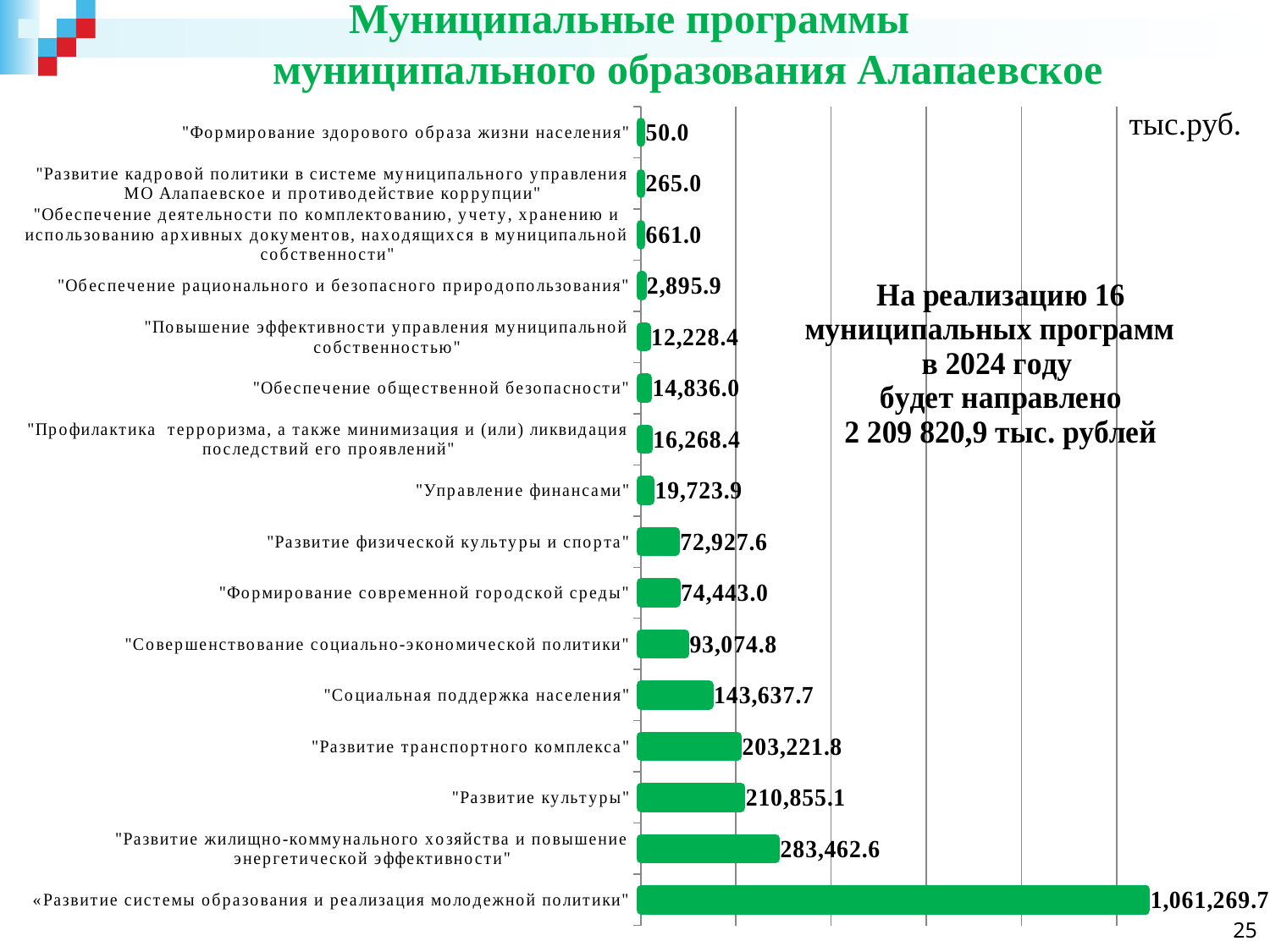
What is the value for "Социальная поддержка населения"? 143,637.7 How many programs (categories) are shown in the chart? 16 What is the value for "Управление финансами"? 19,723.9 What is the difference between the values for "Развитие культуры" and "Развитие транспортного комплекса"? 7,633.3 Which program has the highest value? «Развитие системы образования и реализация молодежной политики" What is the difference between the values for "Развитие жилищно-коммунального хозяйства и повышение энергетической эффективности" and "Социальная поддержка населения"? 139,824.9 Which program has the lowest value? "Формирование здорового образа жизни населения" What is the value for "Обеспечение общественной безопасности"? 14,836.0 In what units are the chart values given, according to the label at the top right of the chart? тыс.руб. What is the value for "Развитие культуры"? 210,855.1 What kind of chart is shown on the slide? Bar chart Which is larger: the value for "Совершенствование социально-экономической политики" or for "Формирование современной городской среды"? "Совершенствование социально-экономической политики"